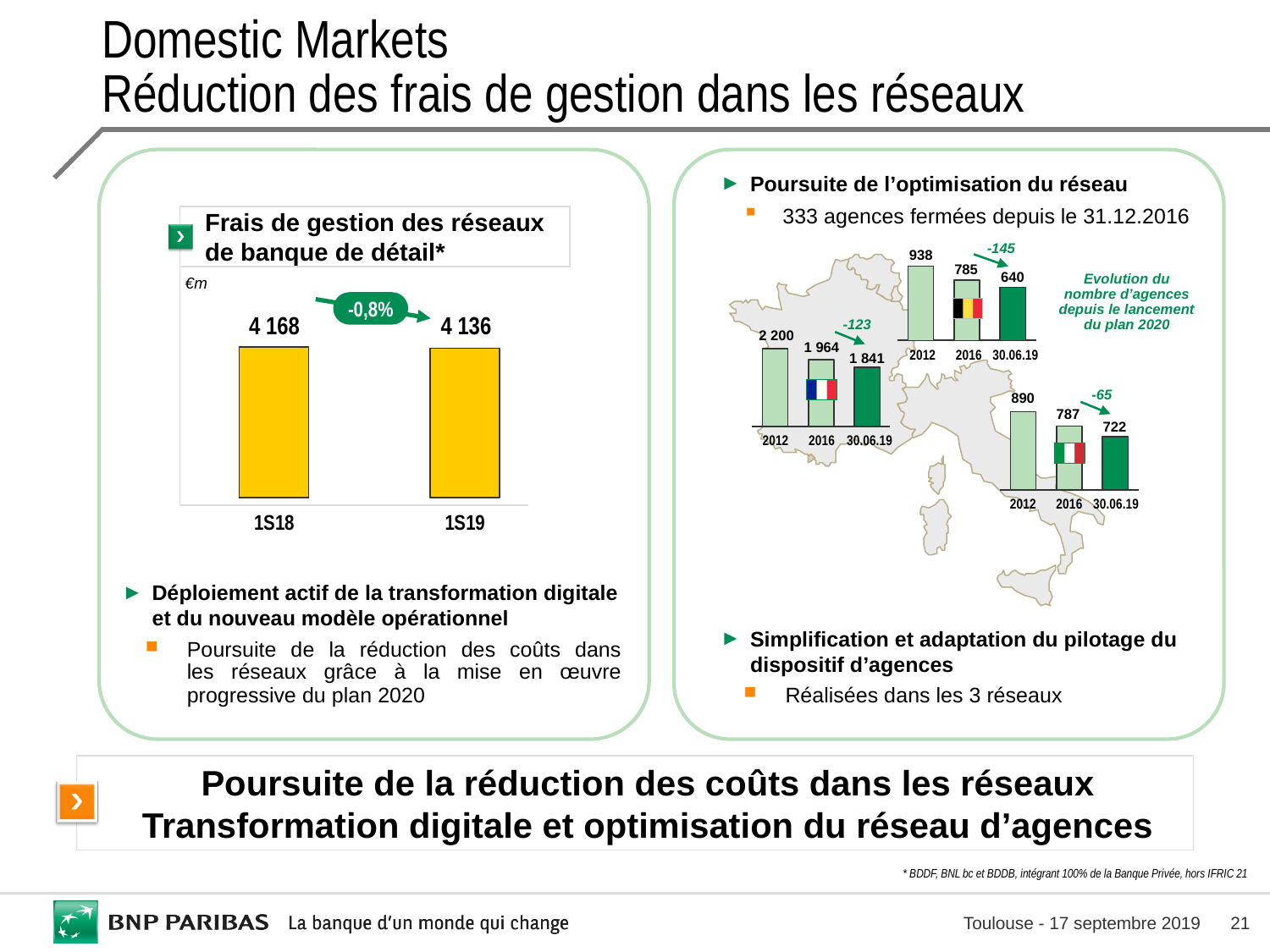
In the branch-count chart on the map with the French flag, what is the value for 2012? 2 200 In the branch-count chart on the map with the Belgian flag, do the values rise or fall from 2012 to 30.06.19? fall In the branch-count chart on the map with the French flag, what is the value for 30.06.19? 1 841 In the chart 'Frais de gestion des réseaux de banque de détail', what is the value for 1S19? 4 136 In the branch-count chart on the map with the Belgian flag, what is the value for 2016? 785 In the chart 'Frais de gestion des réseaux de banque de détail', what unit is indicated for the values? €m In the branch-count chart on the map with the Italian flag, what is the difference between the 2012 value and the 30.06.19 value? 168 In the chart 'Frais de gestion des réseaux de banque de détail', what percentage change is shown between 1S18 and 1S19? -0,8% In the chart 'Frais de gestion des réseaux de banque de détail', what is the difference between the 1S18 and 1S19 values? 32 In the chart 'Frais de gestion des réseaux de banque de détail', what is the value for 1S18? 4 168 What kind of chart is 'Frais de gestion des réseaux de banque de détail'? bar chart In the chart 'Frais de gestion des réseaux de banque de détail', which period has the higher value, 1S18 or 1S19? 1S18